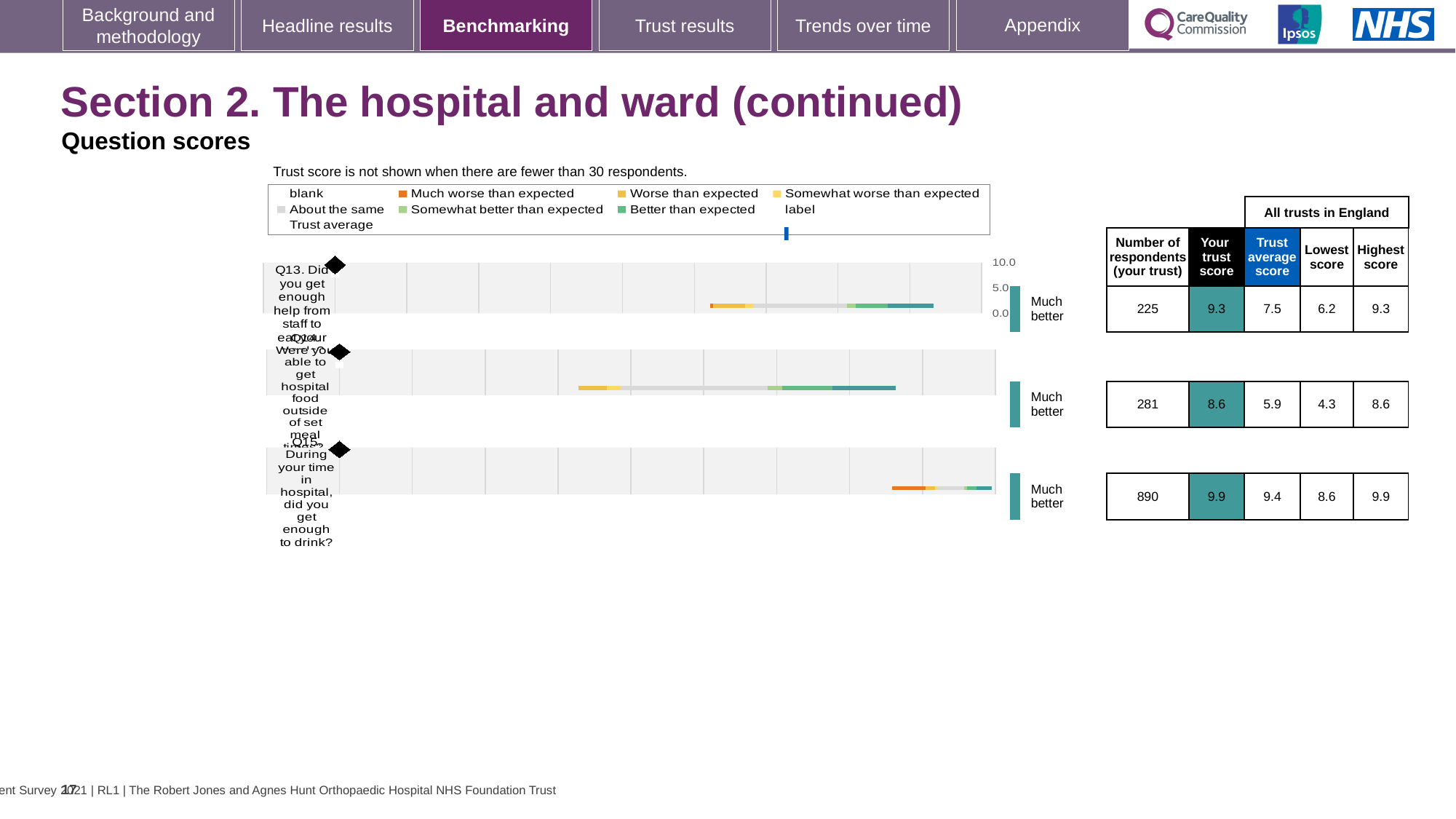
What is the trust average score for Q15 (During your time in hospital, did you get enough to drink?)? 9.4 Which question has the highest 'Your trust score'? Q15 Which question has the lowest 'Lowest score' across all trusts in England? Q14 What kind of chart is used to show the question scores on this slide? bar chart For Q14, what is the difference between 'Your trust score' and the trust average score? 2.7 How many questions are plotted in the chart? 3 How many respondents from your trust answered Q14 (Were you able to get hospital food outside of set meal times?)? 281 Is the trust average score for Q14 greater or less than 5.0? greater What rating label is shown next to each of the three bars in the chart? Much better For Q13, which is larger: 'Your trust score' or the trust average score? Your trust score What is the 'Your trust score' for Q13 (Did you get enough help from staff to eat your meals?)? 9.3 For Q15, what is the difference between the highest score and the lowest score across all trusts in England? 1.3